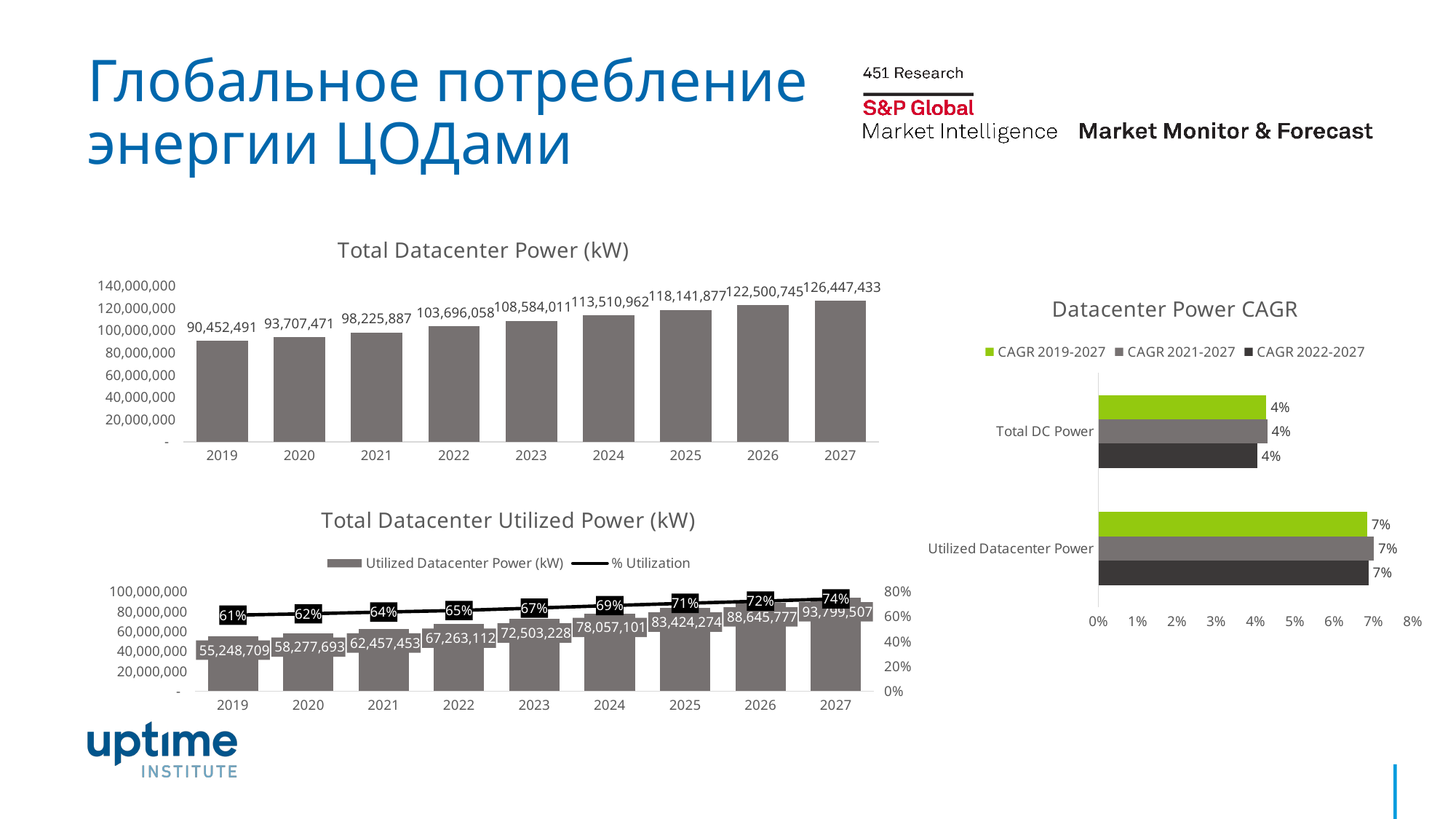
In the Total Datacenter Utilized Power (kW) chart, what is the % Utilization for 2027? 74% In the Total Datacenter Utilized Power (kW) chart, which year has the highest Utilized Datacenter Power? 2027 What kind of chart is the Total Datacenter Power (kW) chart? bar chart In the Total Datacenter Utilized Power (kW) chart, what is the Utilized Datacenter Power value for 2023? 72,503,228 In the Total Datacenter Power (kW) chart, how many years are shown on the x axis? 9 In the Total Datacenter Power (kW) chart, what is the value for 2019? 90,452,491 In the Datacenter Power CAGR chart, which category has the larger CAGR 2022-2027: Total DC Power or Utilized Datacenter Power? Utilized Datacenter Power In the Total Datacenter Power (kW) chart, what is the difference between the 2027 and 2019 values? 35,994,942 In the Total Datacenter Power (kW) chart, what is the value for 2027? 126,447,433 In the Total Datacenter Power (kW) chart, do the values rise or fall from 2019 to 2027? rise How many series does the legend of the Total Datacenter Utilized Power (kW) chart list? 2 In the Datacenter Power CAGR chart, what is the CAGR 2019-2027 for Utilized Datacenter Power? 7%